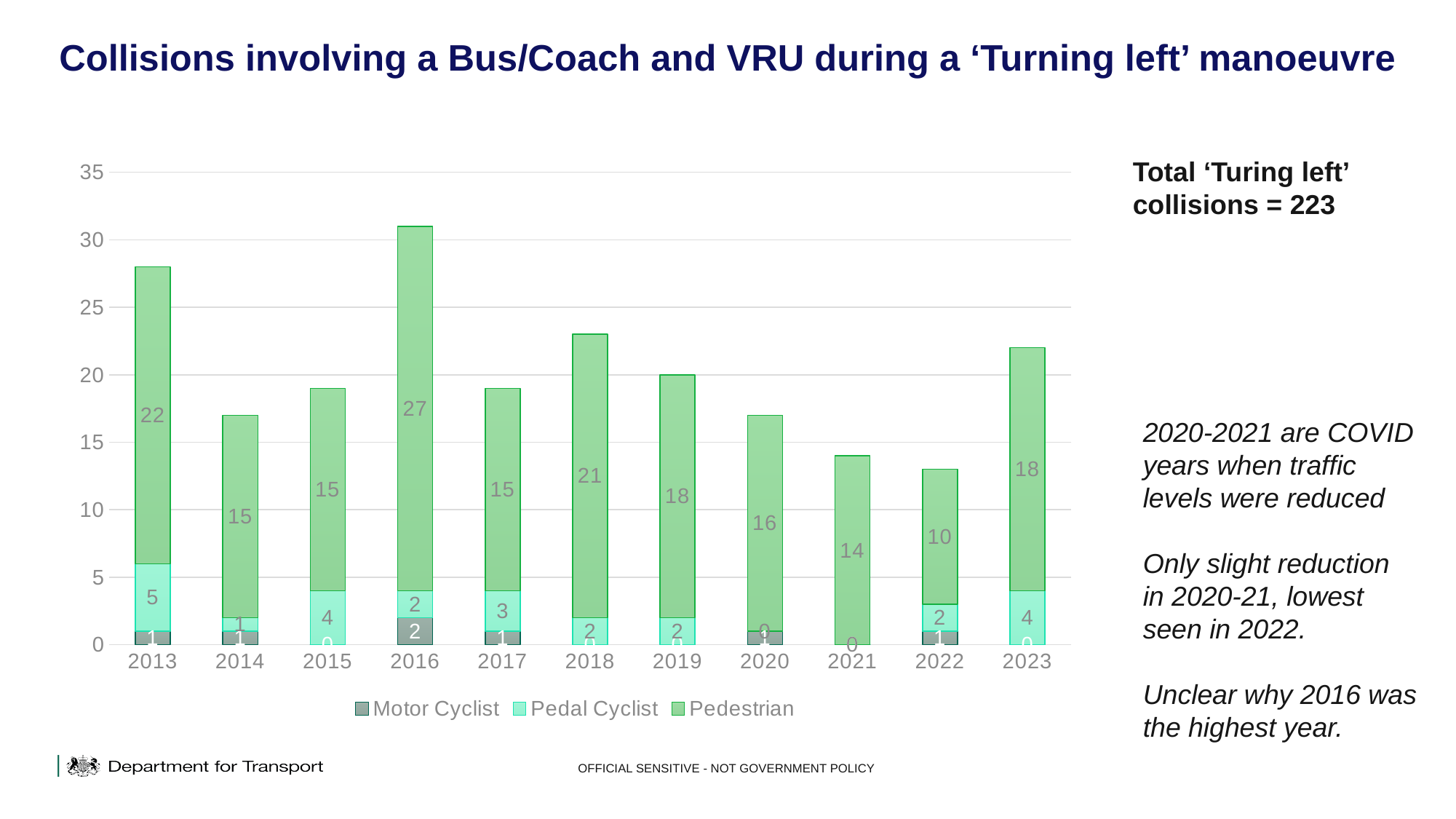
What is the Pedestrian value for 2016? 27 How many series does the legend list? 3 What is the difference between the Pedestrian values for 2016 and 2013? 5 What is the total of the stacked bar for 2016? 31 What is the Pedestrian value for 2022? 10 Which year has the highest Pedestrian value? 2016 What is the Motor Cyclist value for 2016? 2 Which is larger, the Pedestrian value for 2018 or for 2019? 2018 Which year has the lowest Pedestrian value? 2022 What kind of chart is shown on the slide? Stacked bar chart How many years are shown on the x axis? 11 What is the Pedal Cyclist value for 2013? 5